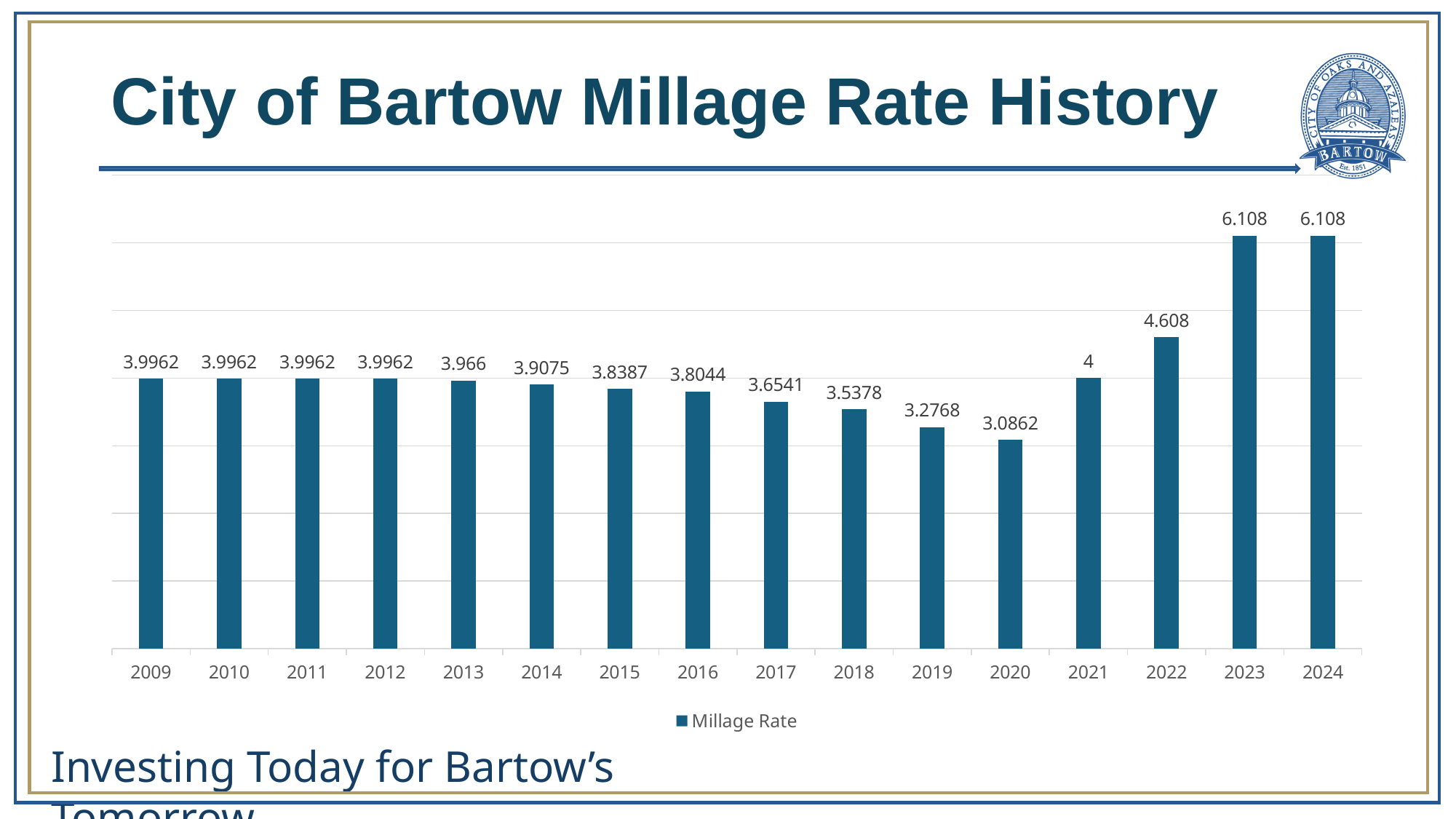
How many years are shown on the x axis of the chart? 16 What is the millage rate for 2017? 3.6541 Which year has the lowest millage rate? 2020 What is the millage rate for 2020? 3.0862 What is the title of the chart on the slide? City of Bartow Millage Rate History What is the difference between the millage rate in 2023 and in 2022? 1.5 Which year has a higher millage rate, 2018 or 2021? 2021 How many series does the legend list? 1 What is the highest millage rate shown on the chart? 6.108 What kind of chart is shown on the slide? Bar chart What is the difference between the millage rate in 2021 and in 2020? 0.9138 What is the millage rate for 2022? 4.608